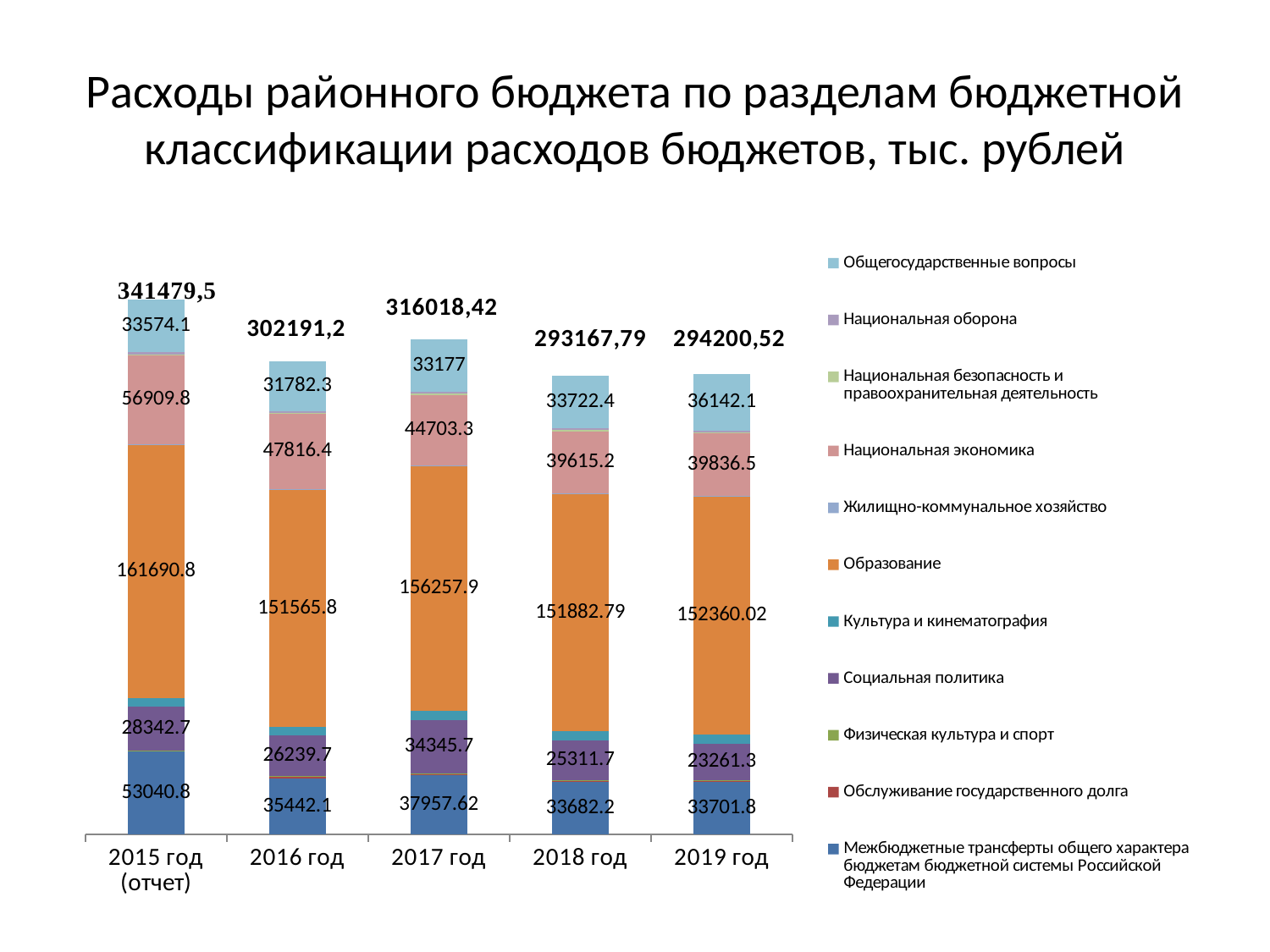
What is the total printed above the bar for 2018 год? 293167,79 Does the value for Национальная экономика rise or fall from 2015 год (отчет) to 2018 год? fall In which year is the value for Социальная политика lowest? 2019 год How many years (categories) are shown on the x axis? 5 What is the value for Образование in 2017 год? 156257.9 What kind of chart is shown on the slide? stacked bar chart What is the value for Национальная экономика in 2015 год (отчет)? 56909.8 What is the value for Общегосударственные вопросы in 2019 год? 36142.1 Which is larger: the Национальная экономика value in 2018 год or in 2019 год? 2019 год How many series does the legend list? 11 What is the difference between the Межбюджетные трансферты values for 2015 год (отчет) and 2016 год? 17598.7 In which year is the total bar value highest? 2015 год (отчет)